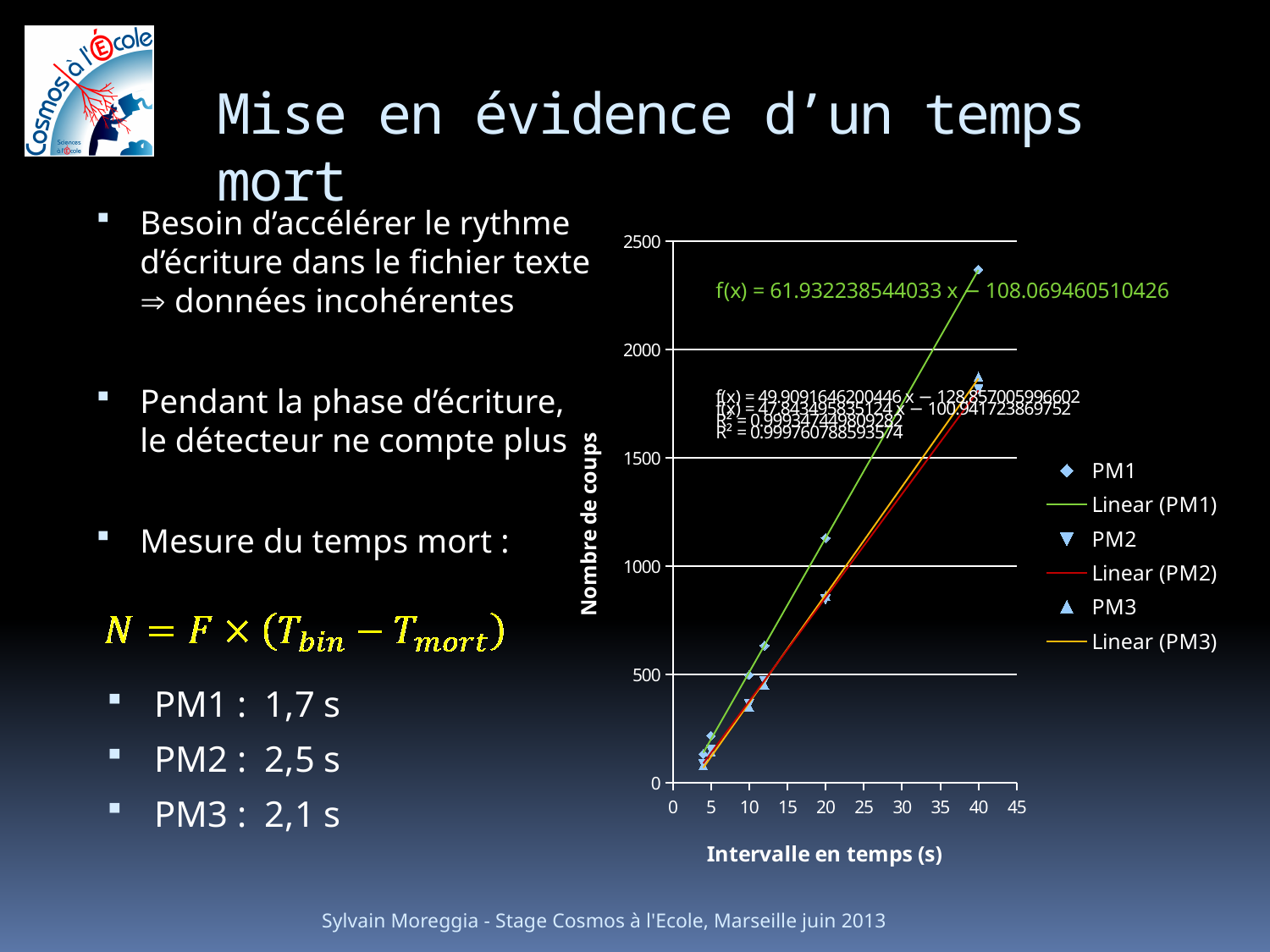
Is the value for PM2 at an interval of 40 s greater or less than 2000? less At an interval of 40 s, which series has the larger value, PM1 or PM2? PM1 Is the value for PM3 at an interval of 20 s greater or less than 1000? less What kind of chart is shown on the slide? scatter chart What is the title of the horizontal axis of the chart? Intervalle en temps (s) Do the values for PM1 rise or fall as the time interval increases? rise What is the title of the vertical axis of the chart? Nombre de coups Is the value for PM1 at an interval of 20 s greater or less than 1000? greater How many entries does the chart legend list? 6 What is the slope printed in the trendline equation for PM1, f(x) = ... x − 108.069460510426? 61.932238544033 Which series reaches the highest number of counts on the chart? PM1